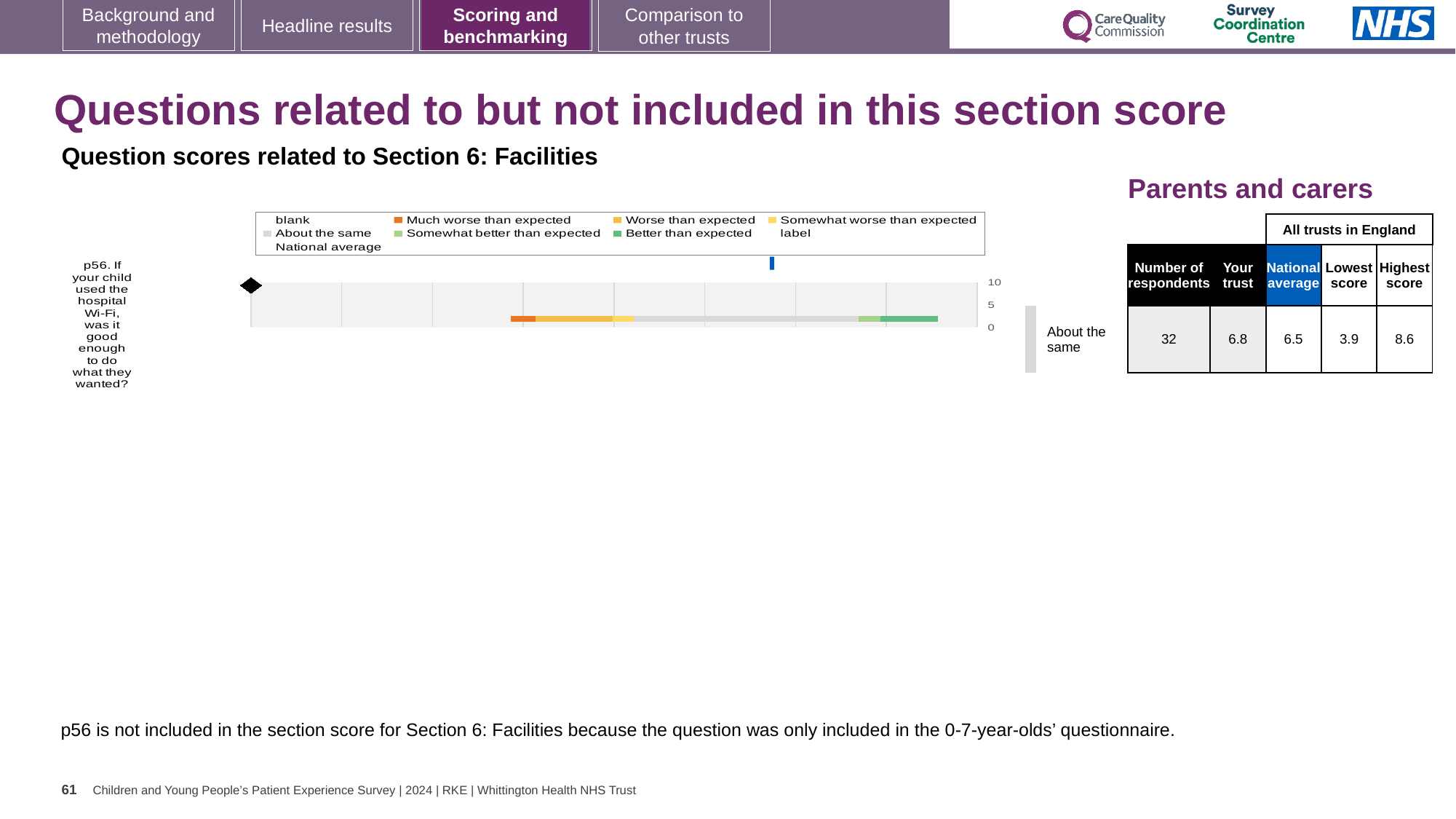
Which is larger for p56, the 'Your trust' score or the national average? Your trust What benchmark category is the trust's p56 score placed in? About the same How many questions are plotted in the chart? 1 What is the difference between the highest score and the lowest score for p56? 4.7 According to the table, what is the highest score among all trusts in England for p56? 8.6 According to the table, what is the 'Your trust' score for p56? 6.8 Which question is plotted in the chart? p56. If your child used the hospital Wi-Fi, was it good enough to do what they wanted? How many respondents answered p56? 32 What colour does the legend use for 'Much worse than expected'? Orange What kind of chart is shown on the slide? Bar chart According to the table, what is the lowest score among all trusts in England for p56? 3.9 According to the table, what is the national average score for p56? 6.5